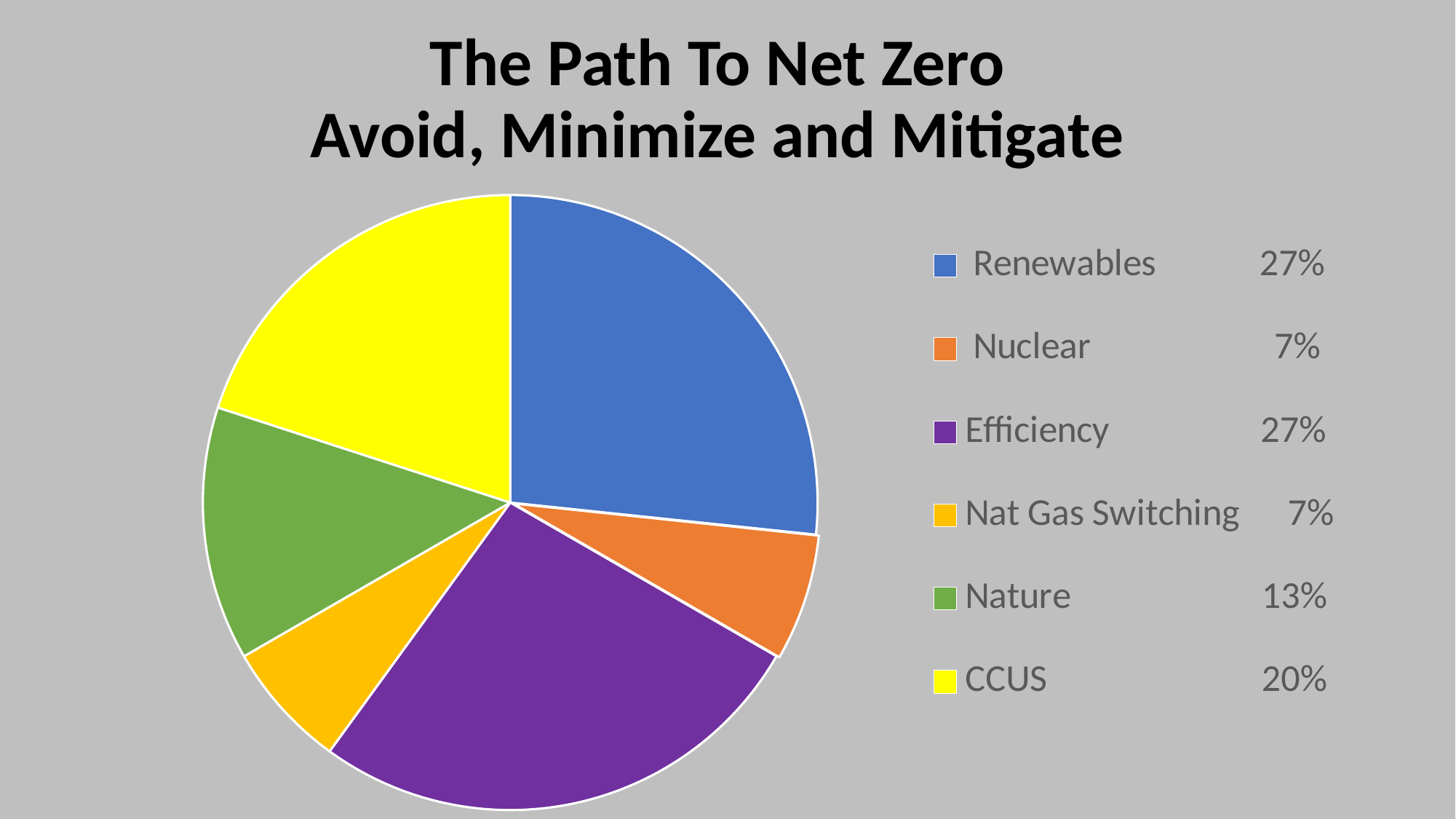
How many categories are shown in the pie chart? 6 What share of the pie does Nature account for? 13% What is the value shown for Nuclear? 7% What is the difference between the share for CCUS and the share for Nature? 7% What share of the pie does CCUS account for? 20% What is the value shown for Efficiency? 27% What is the value shown for Nat Gas Switching? 7% What share of the pie does Renewables account for? 27% What is the difference between the share for Renewables and the share for Nuclear? 20% Which colour represents CCUS in the pie chart? yellow Which is larger, the share for CCUS or the share for Nature? CCUS What kind of chart is shown on the slide? pie chart